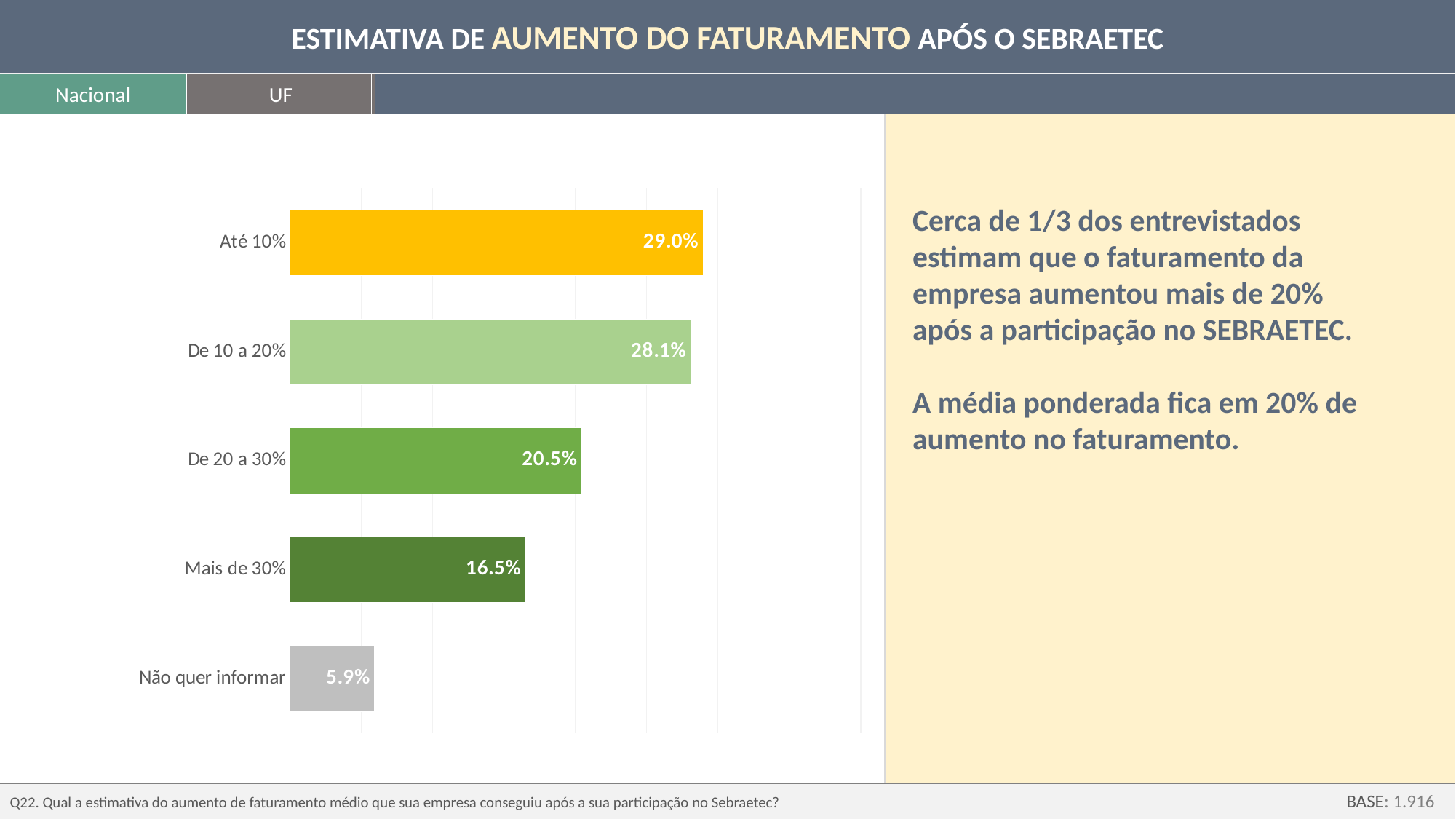
What colour is the bar for "Até 10%"? Yellow What is the difference between the values for "De 20 a 30%" and "Mais de 30%"? 4.0% How many categories are shown in the chart? 5 What is the value for "Mais de 30%"? 16.5% What is the value for "De 10 a 20%"? 28.1% Which is larger, the value for "De 20 a 30%" or the value for "Mais de 30%"? De 20 a 30% What is the difference between the values for "Até 10%" and "De 10 a 20%"? 0.9% What is the value for "Até 10%"? 29.0% What is the value for "Não quer informar"? 5.9% Which category has the highest value? Até 10% Which category has the lowest value? Não quer informar What kind of chart is shown on the slide? Bar chart